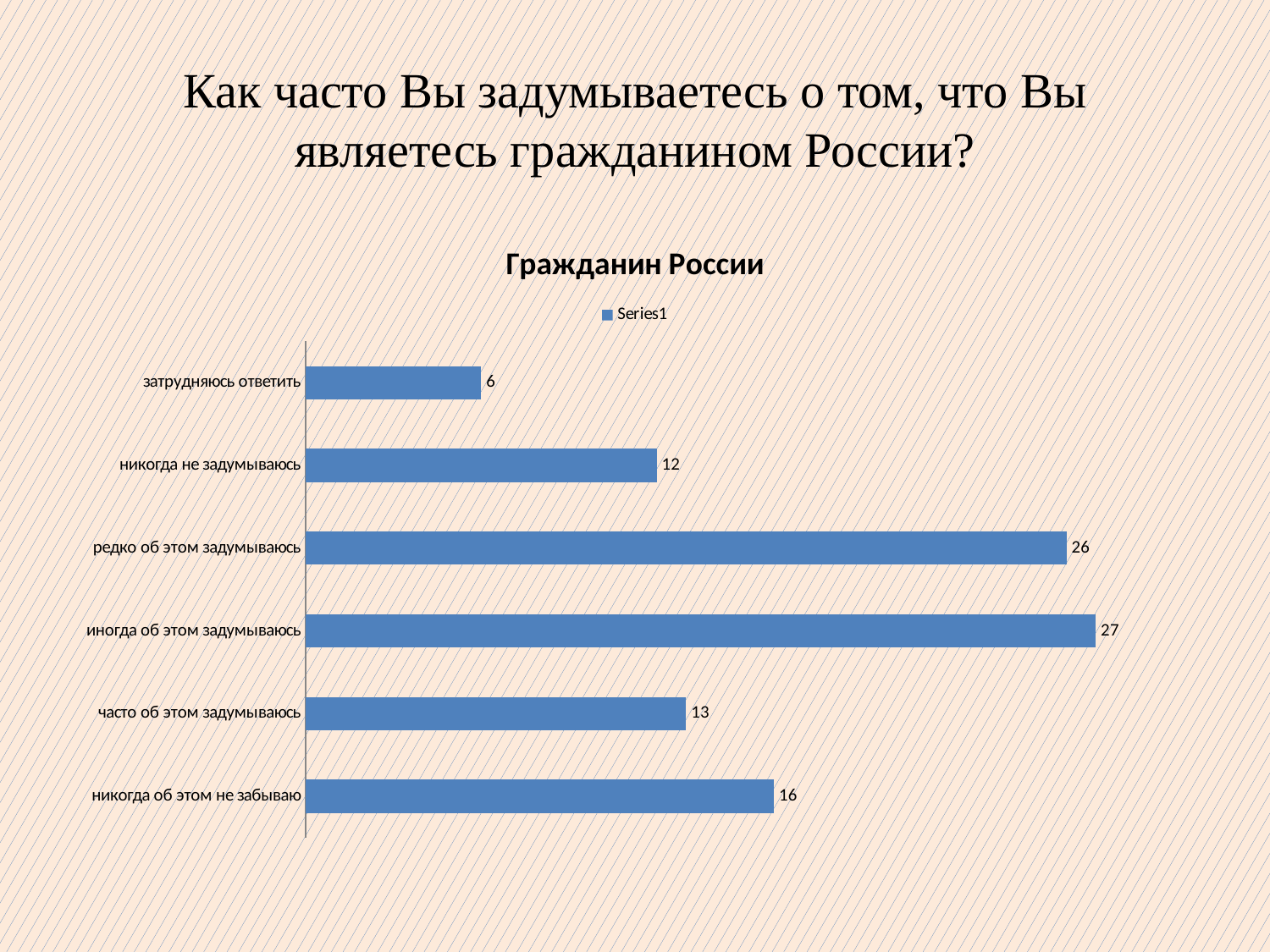
How many series does the legend list? 1 Which is larger: the value for "никогда об этом не забываю" or the value for "часто об этом задумываюсь"? никогда об этом не забываю What is the value for "иногда об этом задумываюсь"? 27 What kind of chart is shown on the slide? bar chart Which category has the highest value? иногда об этом задумываюсь Which category has the lowest value? затрудняюсь ответить How many categories are shown in the chart? 6 What is the title of the chart? Гражданин России What is the value for "часто об этом задумываюсь"? 13 What is the value for "никогда об этом не забываю"? 16 What is the value for "затрудняюсь ответить"? 6 What is the difference between the values for "редко об этом задумываюсь" and "никогда не задумываюсь"? 14